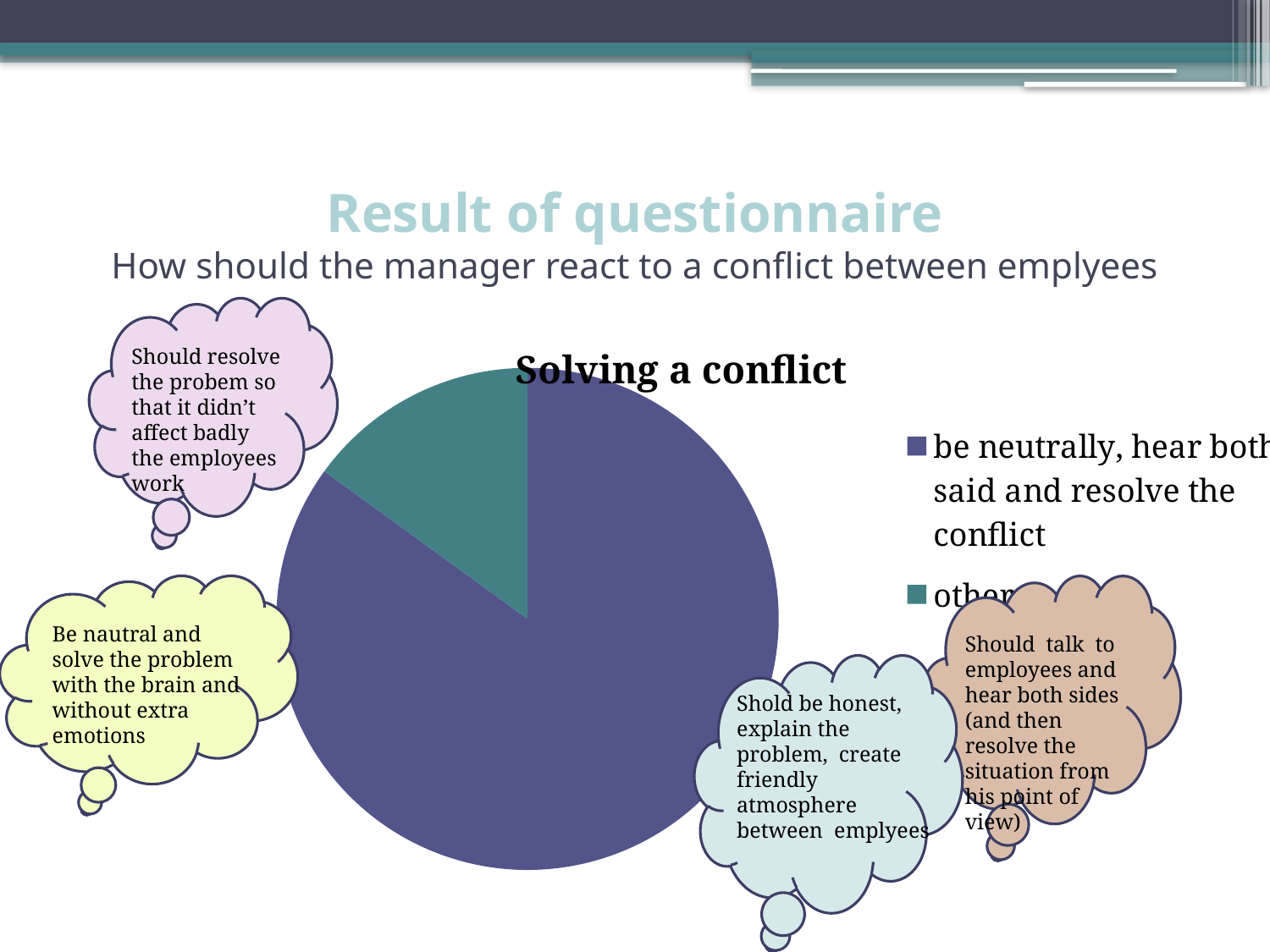
What is the title of the chart? Solving a conflict How many entries does the chart legend list? 2 What kind of chart is shown on the slide? pie chart Which slice of the pie chart is the largest? be neutrally, hear both said and resolve the conflict How many slices does the pie chart have? 2 Which is larger: the slice for 'other' or the slice for 'be neutrally, hear both said and resolve the conflict'? be neutrally, hear both said and resolve the conflict What colour is the slice for 'other' in the pie chart? teal Which slice of the pie chart is the smallest? other